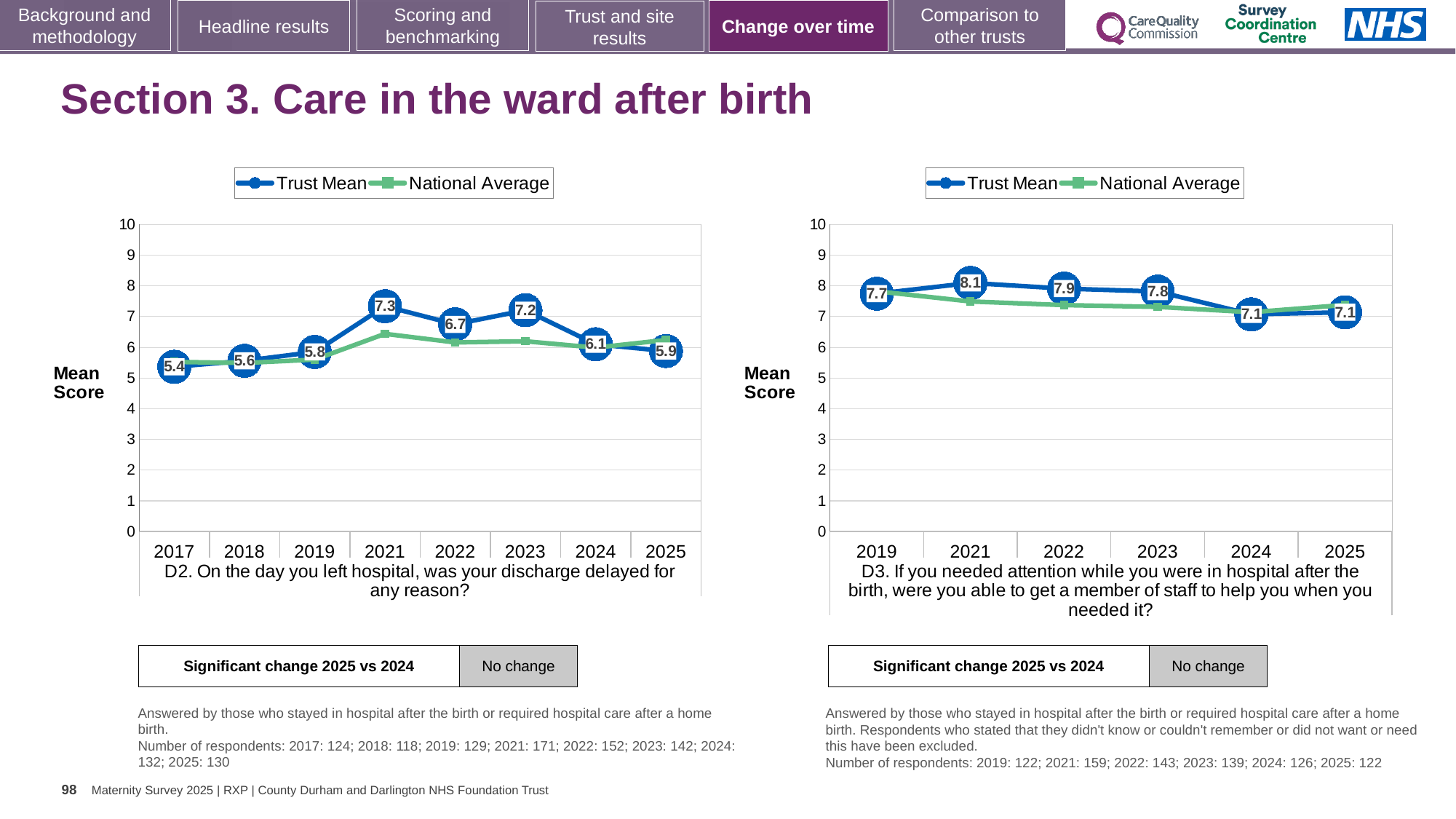
In the left chart (D2, discharge delayed), how many years are plotted on the x axis? 8 In the right chart (D3, able to get a member of staff to help), which year has the highest Trust Mean? 2021 In the right chart (D3, able to get a member of staff to help), what is the Trust Mean for 2025? 7.1 In the right chart (D3, able to get a member of staff to help), how many series does the legend list? 2 In the left chart (D2, discharge delayed), what is the difference between the Trust Mean for 2023 and 2024? 1.1 In the left chart (D2, discharge delayed), what is the Trust Mean for 2021? 7.3 In the left chart (D2, discharge delayed), what is the Trust Mean for 2017? 5.4 What kind of chart is the left chart (D2, discharge delayed)? line chart In the right chart (D3, able to get a member of staff to help), what is the Trust Mean for 2021? 8.1 In the left chart (D2, discharge delayed), which year has the lowest Trust Mean? 2017 In the left chart (D2, discharge delayed), which year has the highest Trust Mean? 2021 In the right chart (D3, able to get a member of staff to help), is the Trust Mean for 2019 larger or smaller than the Trust Mean for 2022? smaller